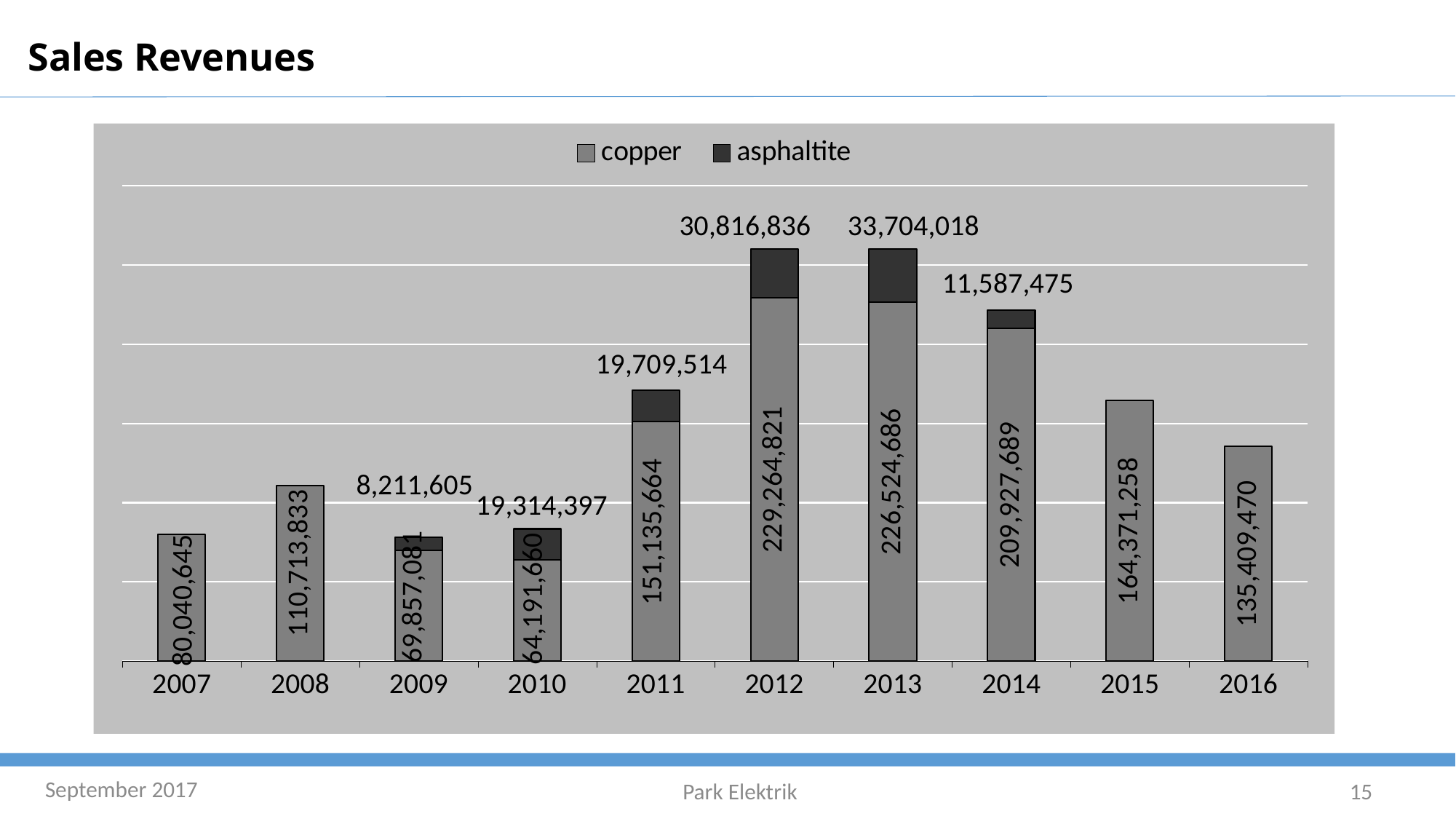
Which year has the lowest copper sales revenue? 2010 Which is larger, the copper sales revenue in 2008 or in 2007? 2008 What kind of chart is shown on the slide? Stacked bar chart What is the copper sales revenue for 2016? 135,409,470 What is the total sales revenue (copper plus asphaltite) for 2014? 221,515,164 What is the difference between the copper sales revenue in 2011 and in 2010? 86,944,004 How many years are shown on the x axis? 10 What is the asphaltite sales revenue for 2013? 33,704,018 What is the copper sales revenue for 2012? 229,264,821 Which year has the lowest asphaltite sales revenue among the years where it is shown? 2009 Which year has the highest asphaltite sales revenue? 2013 How many series does the legend list? 2